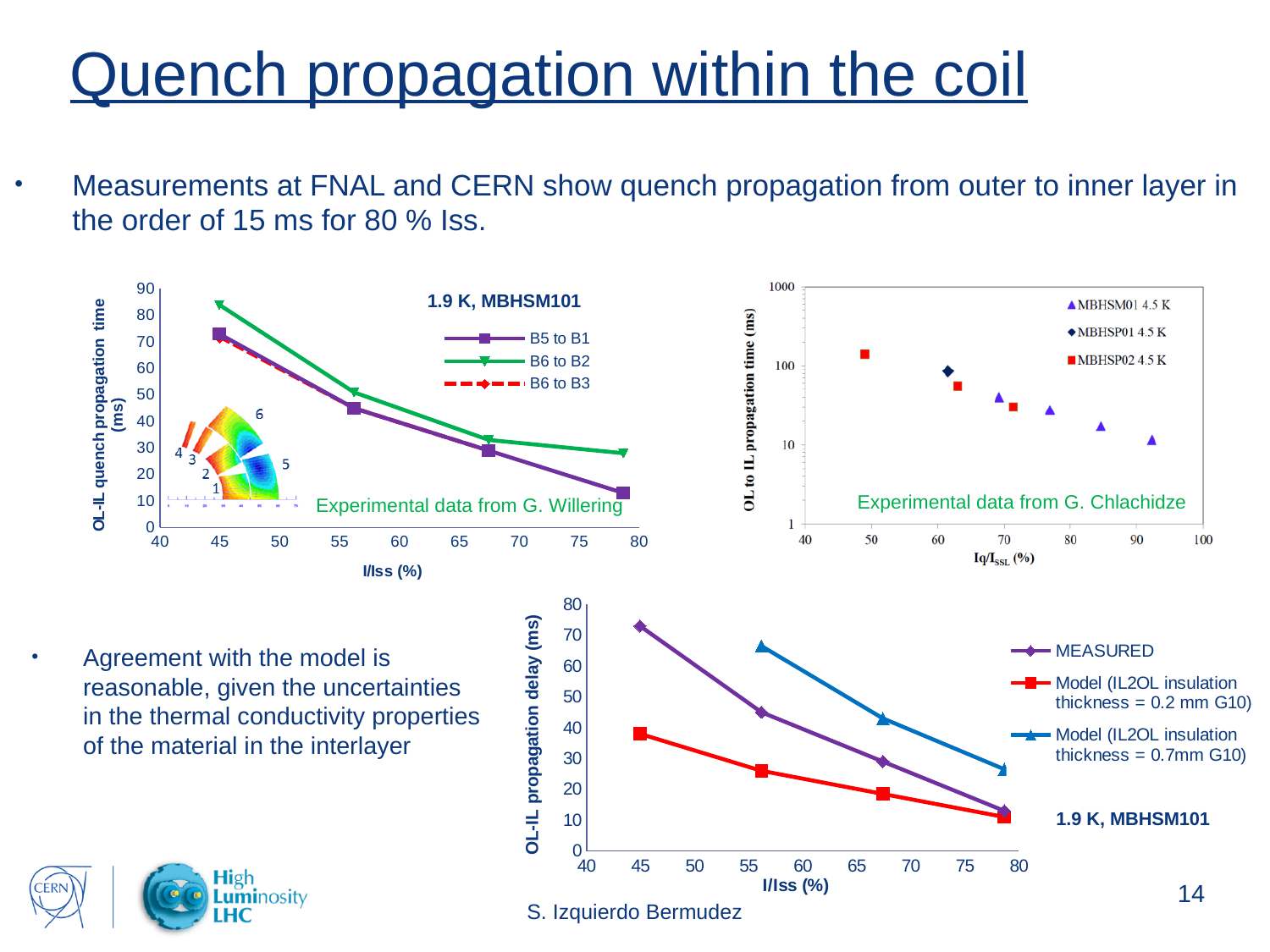
In the top-right chart (experimental data from G. Chlachidze), is the MBHSP02 4.5 K value at Iq/Issl near 49 greater or less than 100? greater In the top-right chart (experimental data from G. Chlachidze), do the propagation times rise or fall as Iq/Issl increases? fall In the top-right chart (experimental data from G. Chlachidze), how many series does the legend list? 3 In the top-left chart titled "1.9 K, MBHSM101", at the highest I/Iss point near 79, which series has the larger value, B6 to B2 or B5 to B1? B6 to B2 In the top-left chart titled "1.9 K, MBHSM101", how many data points does the B5 to B1 series have? 4 In the bottom chart (OL-IL propagation delay), at I/Iss near 56, which series has the larger value, Model (IL2OL insulation thickness = 0.7mm G10) or Model (IL2OL insulation thickness = 0.2 mm G10)? Model (IL2OL insulation thickness = 0.7mm G10) What kind of chart is the top-left chart titled "1.9 K, MBHSM101"? line chart In the top-left chart titled "1.9 K, MBHSM101", does the B5 to B1 series rise or fall as I/Iss increases? fall In the top-left chart titled "1.9 K, MBHSM101", is the B6 to B2 value at I/Iss 45 greater or less than 70? greater In the bottom chart (OL-IL propagation delay), how many series does the legend list? 3 In the top-left chart titled "1.9 K, MBHSM101", how many series does the legend list? 3 In the bottom chart (OL-IL propagation delay), is the MEASURED value at I/Iss 45 greater or less than 60? greater